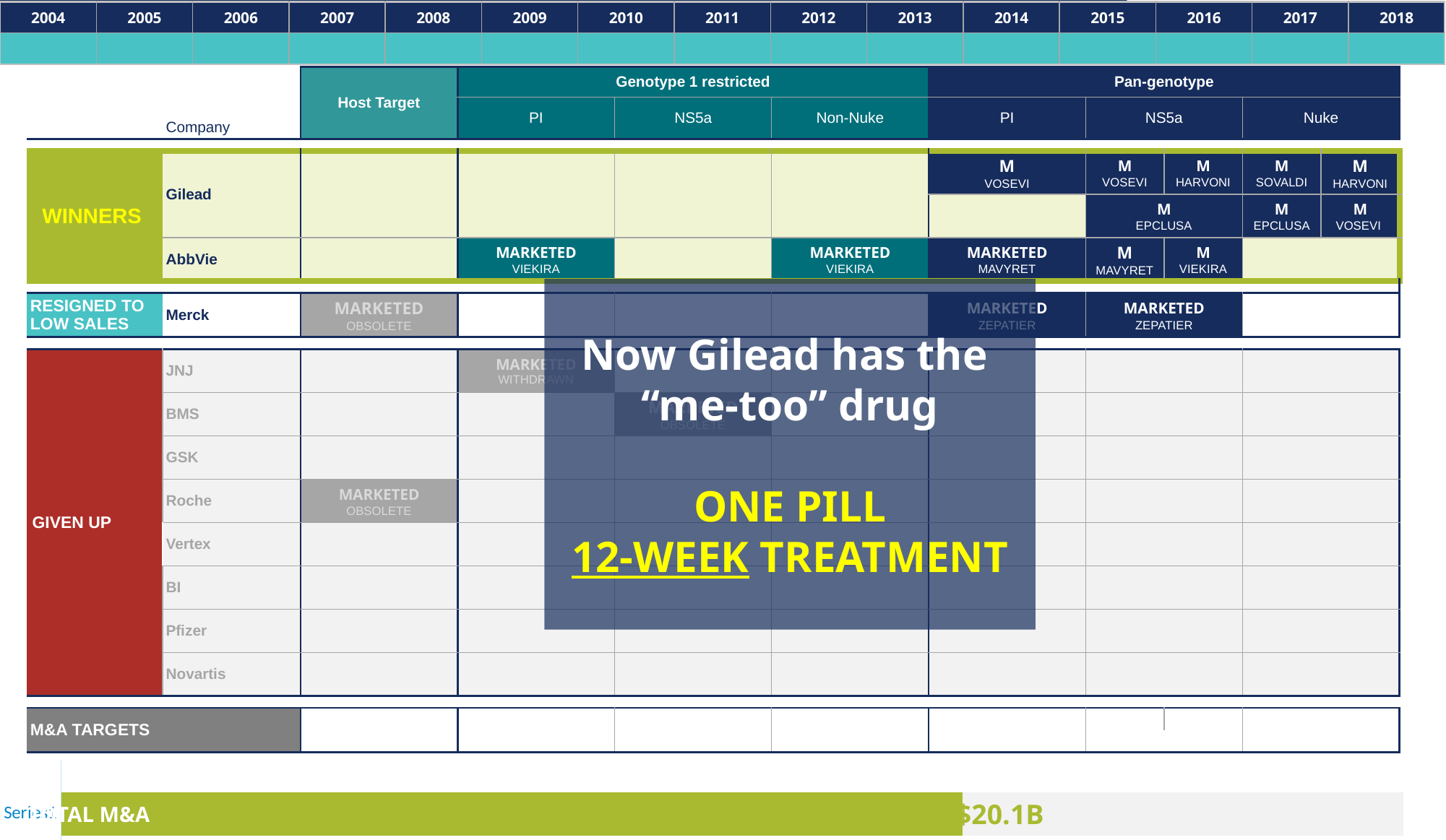
What kind of chart is shown at the bottom of the slide? bar chart Is the bar in the chart at the bottom of the slide horizontal or vertical? horizontal What value is printed on the bar at the bottom of the slide? $20.1B What colour is the bar in the chart at the bottom of the slide? green How many bars does the chart at the bottom of the slide contain? 1